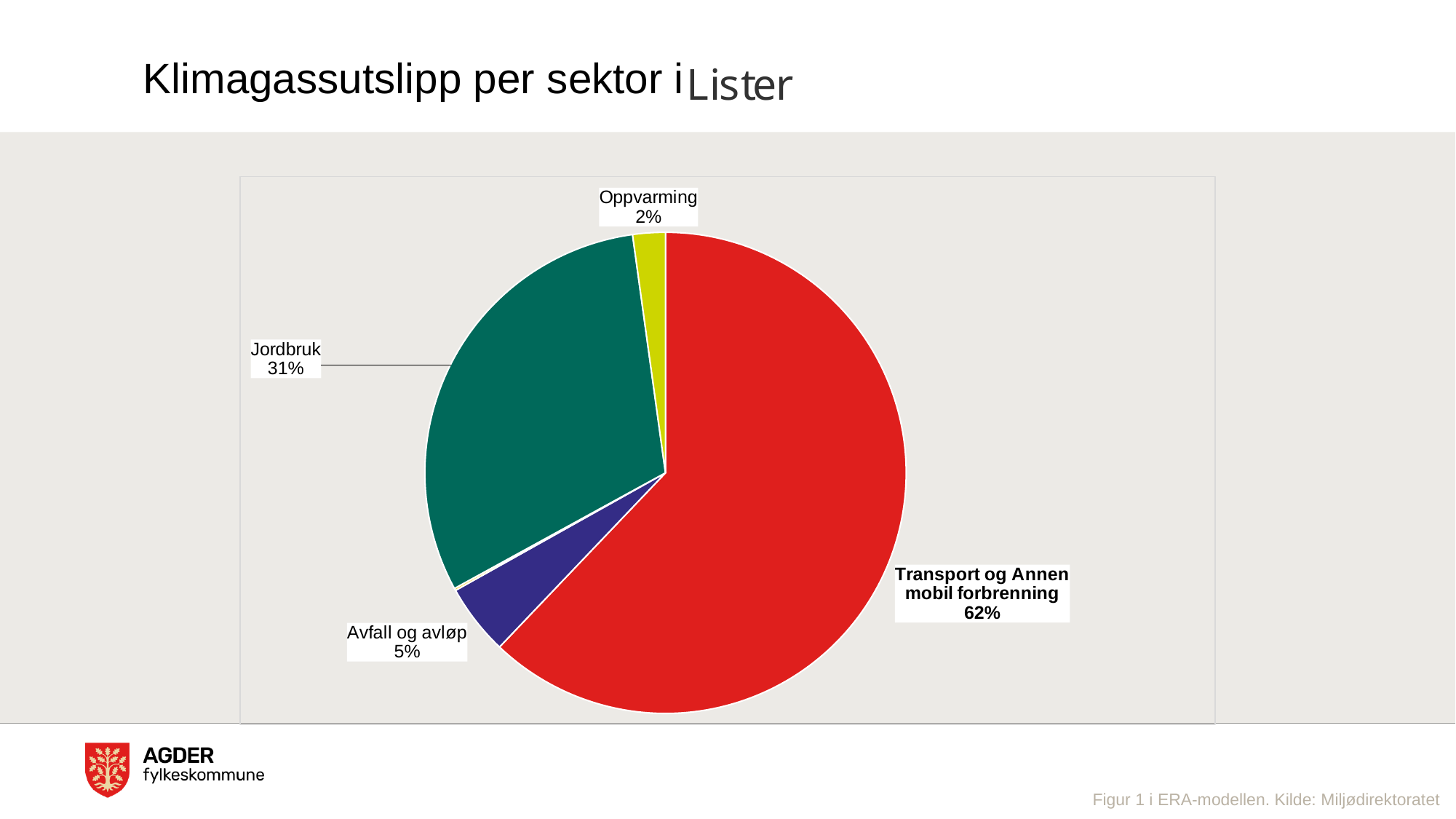
Which is larger, the share for Avfall og avløp or the share for Oppvarming? Avfall og avløp Which sector has the largest share of the pie? Transport og Annen mobil forbrenning Which sector has the smallest share of the pie? Oppvarming What share of emissions does Oppvarming account for? 2% What colour is the slice for Jordbruk? green What share of emissions does Transport og Annen mobil forbrenning account for? 62% What kind of chart is shown on the slide? pie chart How many sectors are shown in the pie chart? 4 What is the title of the chart on the slide? Klimagassutslipp per sektor i Lister What is the difference in percentage points between Transport og Annen mobil forbrenning and Jordbruk? 31 What share of emissions does Jordbruk account for? 31% What share of emissions does Avfall og avløp account for? 5%